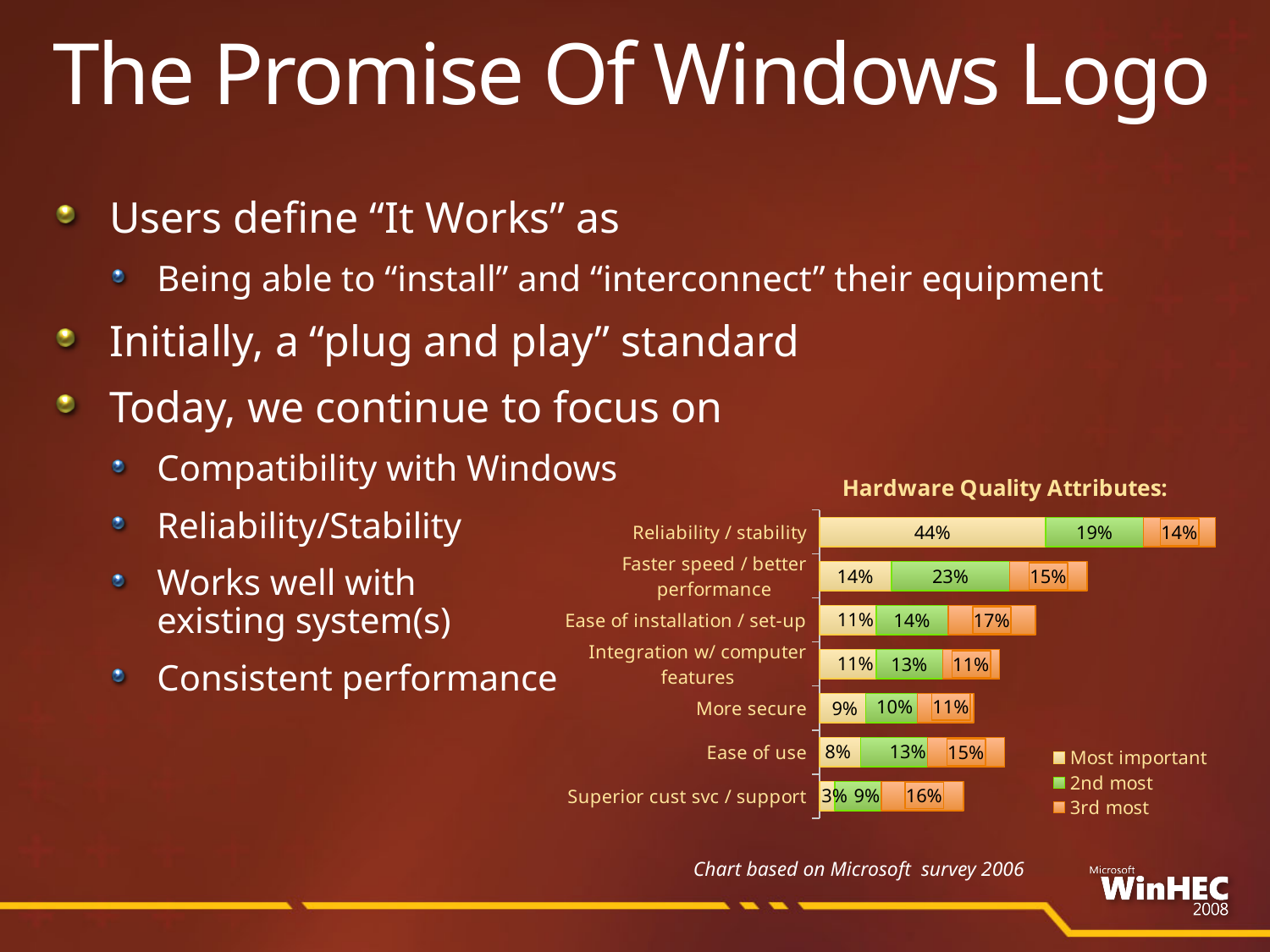
How many categories are shown in the chart? 7 What is the title of the chart? Hardware Quality Attributes: Which category has the lowest "Most important" value? Superior cust svc / support What kind of chart is shown on the slide? Stacked bar chart Which is larger: the "3rd most" value for Ease of installation / set-up or the "3rd most" value for More secure? Ease of installation / set-up Which category has the highest "Most important" value? Reliability / stability What is the difference between the "Most important" values for Reliability / stability and Faster speed / better performance? 30% What is the total of the stacked bar for Reliability / stability? 77% What is the "2nd most" value for Faster speed / better performance? 23% What is the "Most important" value for Reliability / stability? 44% What is the "3rd most" value for Superior cust svc / support? 16% How many series does the legend list? 3